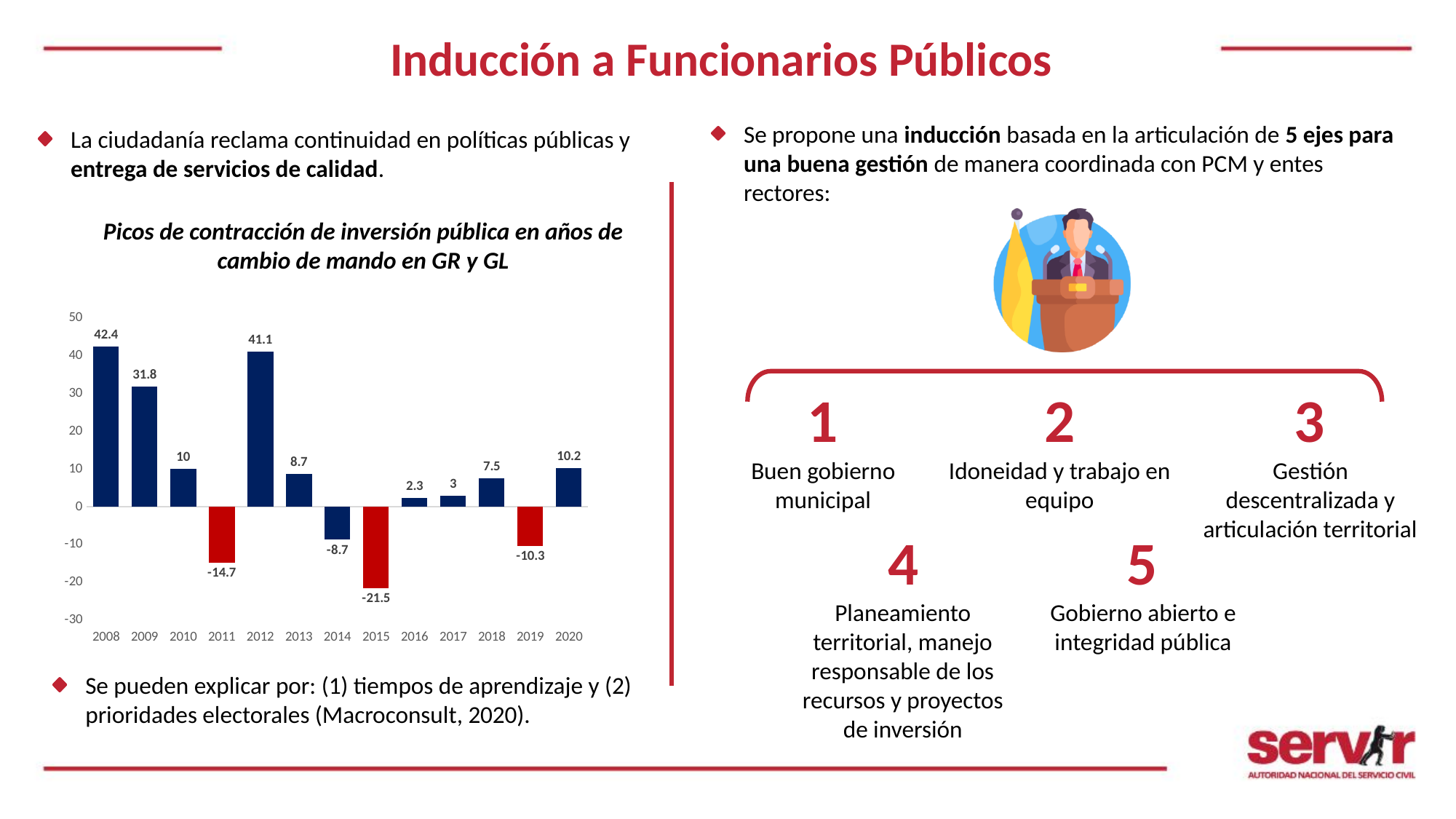
What colour are the bars with negative values? Red How many years are shown on the x axis? 13 Which year has the highest value? 2008 What is the value for 2008? 42.4 What kind of chart is shown on the slide? Bar chart How many years have negative values in the chart? 4 Which year has the lowest value? 2015 What is the value for 2019? -10.3 Is the value for 2009 greater or less than 30? greater What is the value for 2015? -21.5 What is the difference between the values for 2008 and 2012? 1.3 Which is larger, the value for 2010 or the value for 2020? 2020